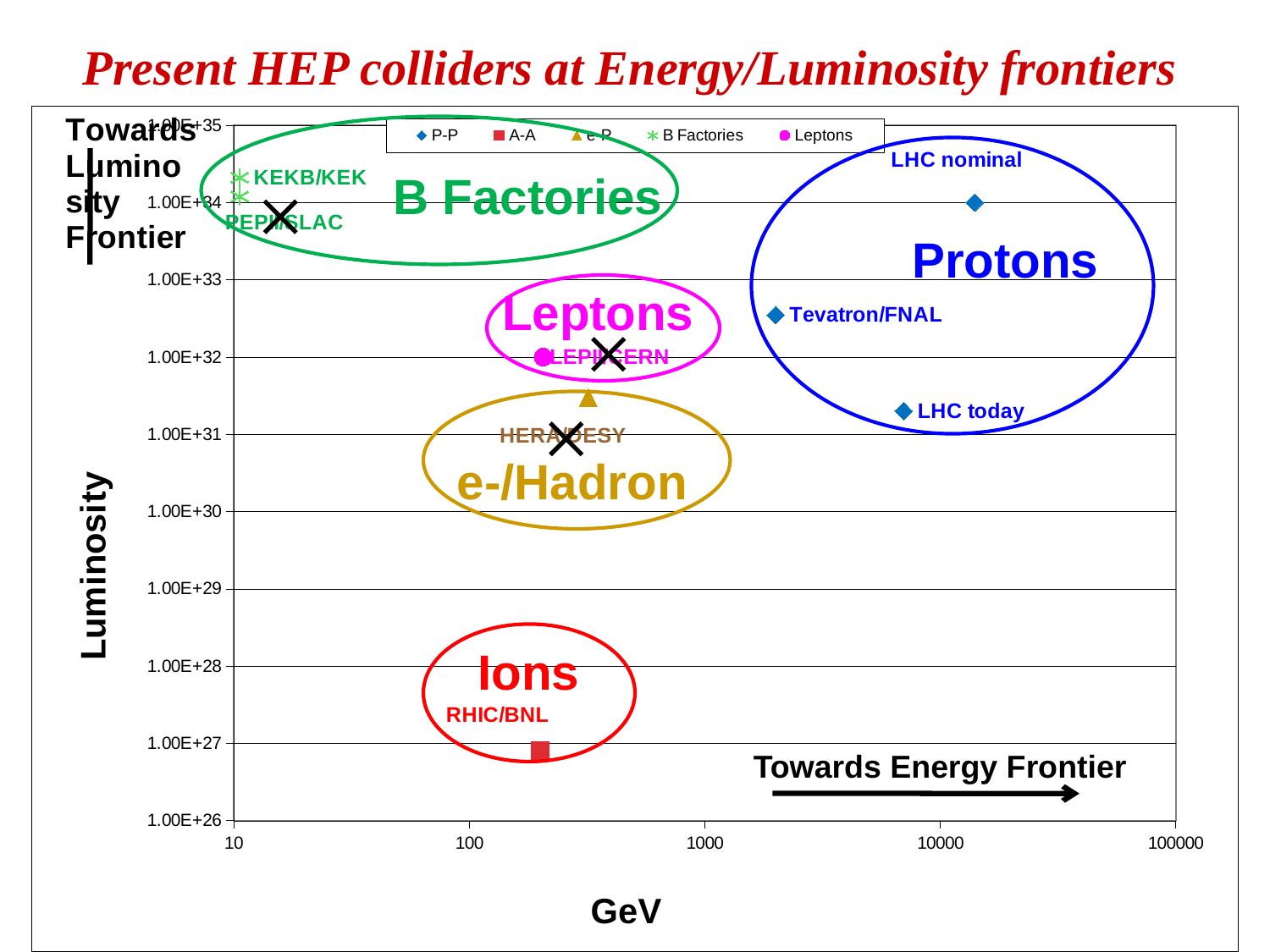
Which has the higher luminosity, LHC nominal or LHC today? LHC nominal Is the luminosity value for Tevatron/FNAL greater or less than 1.00E+33? less Which has the higher luminosity, HERA/DESY or LEP/CERN? LEP/CERN Is the luminosity value for RHIC/BNL greater or less than 1.00E+27? less Which labelled collider has the highest energy (GeV) on the chart? LHC nominal Which labelled collider has the lowest luminosity on the chart? RHIC/BNL What is the title of the slide? Present HEP colliders at Energy/Luminosity frontiers Is the energy (GeV) value for LHC nominal greater or less than 10000? greater How many series does the chart legend list? 5 What kind of chart is shown on the slide? scatter chart What is the label of the x axis? GeV